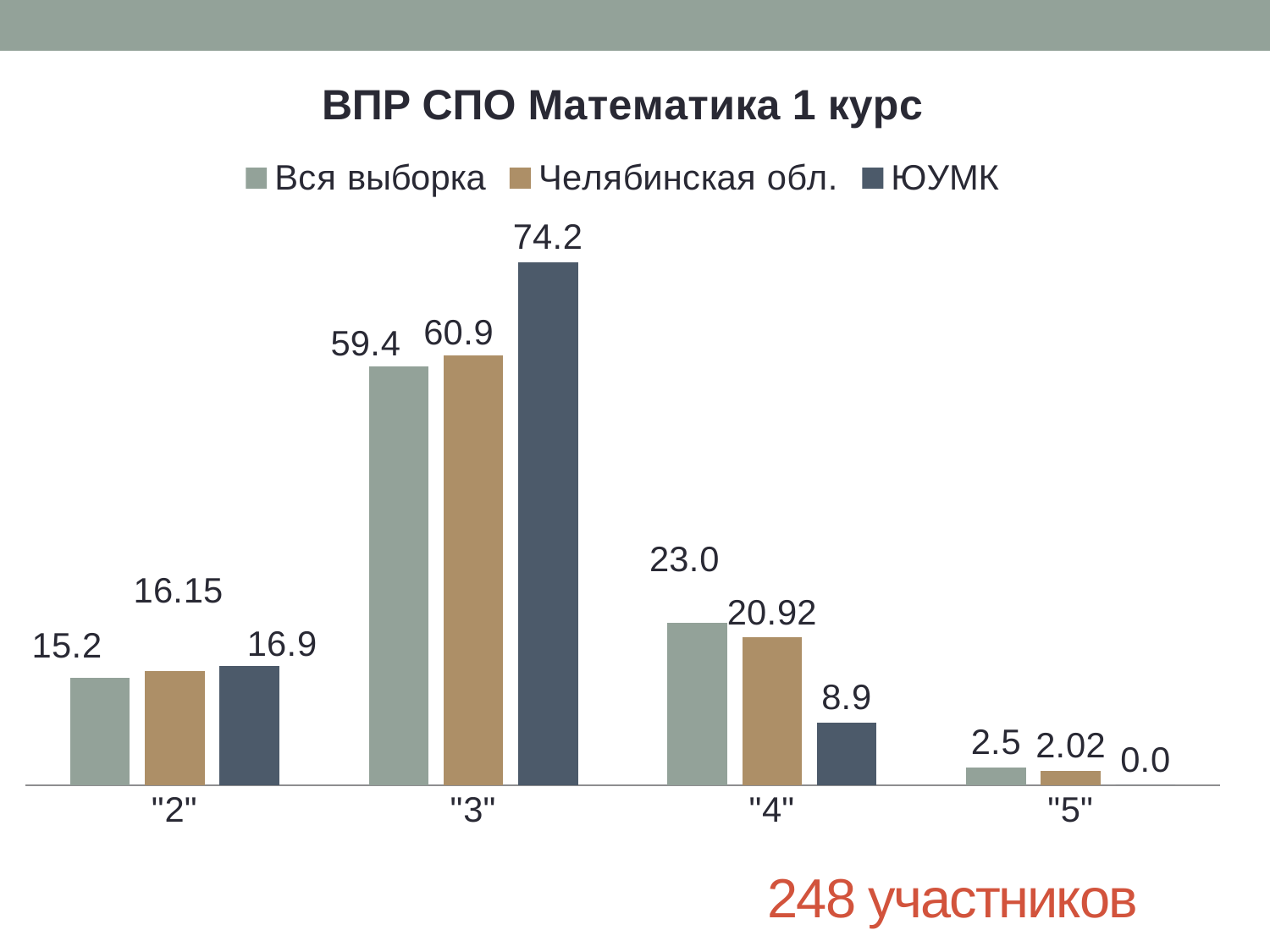
Which category has the lowest value for Вся выборка? "5" Which category has the highest value for ЮУМК? "3" Which is larger in the "4" category: Вся выборка or ЮУМК? Вся выборка What is the value for ЮУМК in the "3" category? 74.2 How many categories are shown on the x axis? 4 What kind of chart is shown on the slide? Bar chart What is the value for Вся выборка in the "2" category? 15.2 What is the title of the chart? ВПР СПО Математика 1 курс What is the value for ЮУМК in the "5" category? 0.0 How many series does the legend list? 3 What is the value for Челябинская обл. in the "4" category? 20.92 What is the difference between the ЮУМК and Вся выборка values in the "3" category? 14.8